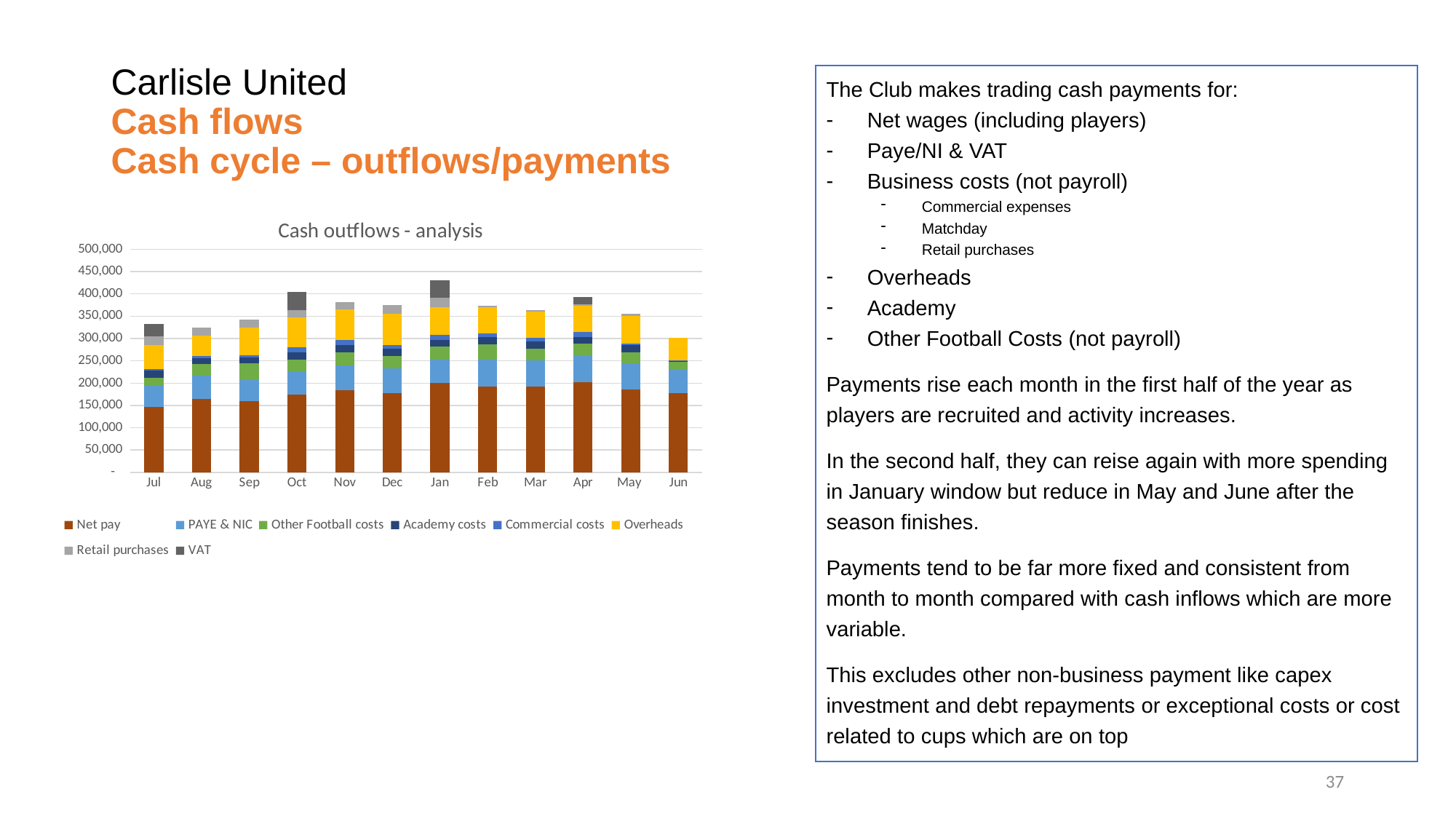
Which month has the highest total cash outflow? Jan Is the Net pay value for Jan greater or less than 150,000? greater Do total cash outflows generally rise or fall from Jul to Jan? rise Which month has the lowest total cash outflow? Jun What is the title of the chart? Cash outflows - analysis What kind of chart is shown on the slide? Stacked bar chart Is the total cash outflow for Jun greater or less than 350,000? less How many series does the chart legend list? 8 Which series is shown at the bottom of each stacked bar? Net pay Which month has the larger total cash outflow, Oct or Aug? Oct How many months are shown on the x axis of the chart? 12 Is the total cash outflow for Jan greater or less than 400,000? greater